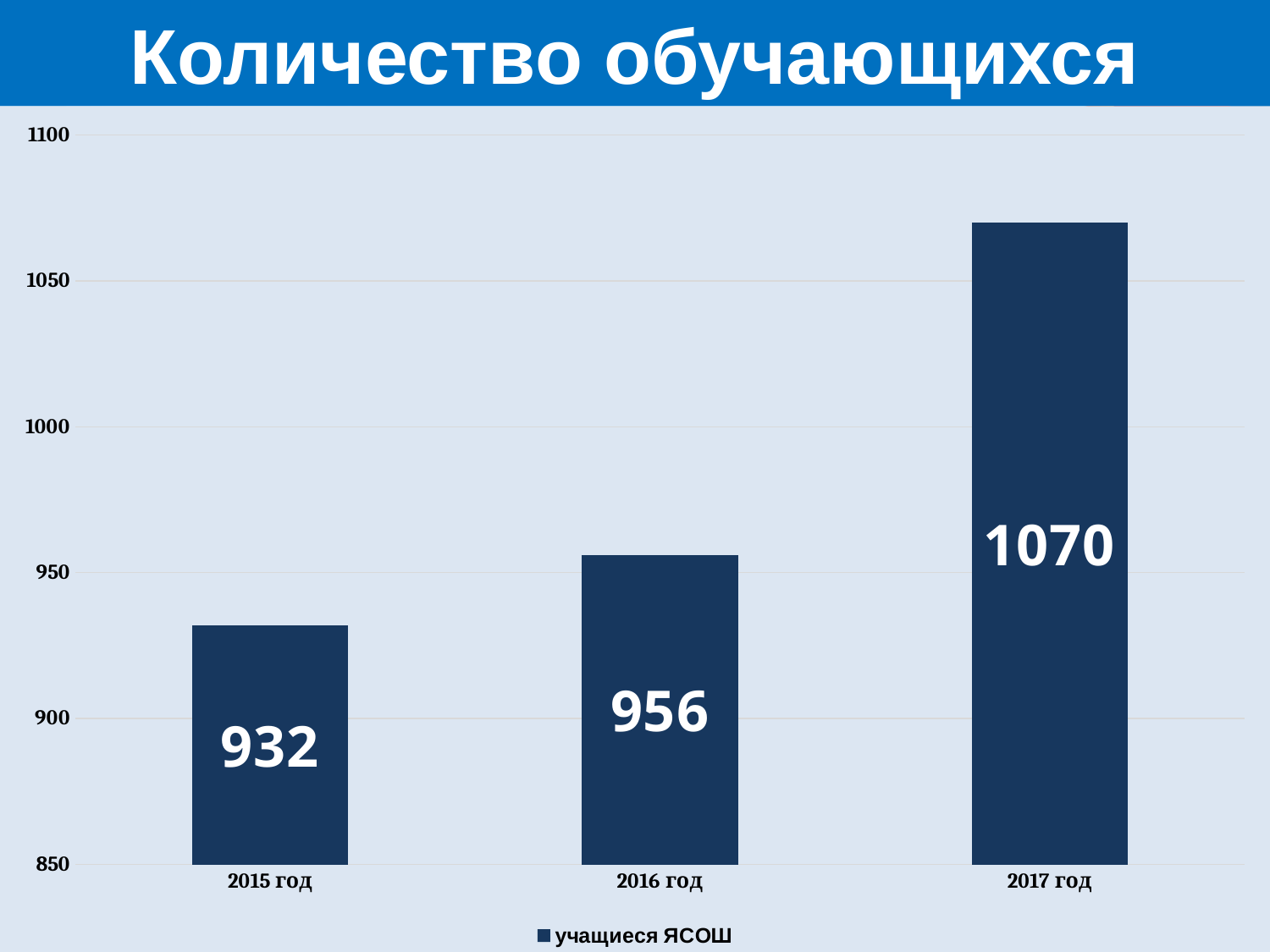
Do the values rise or fall from 2015 год to 2017 год? rise What is the value for 2015 год? 932 What kind of chart is shown on the slide? bar chart What is the difference between the values for 2016 год and 2015 год? 24 Which year has the highest value? 2017 год What is the difference between the values for 2017 год and 2016 год? 114 What is the value for 2017 год? 1070 What is the value for 2016 год? 956 Is the value for 2017 год greater or less than 1050? greater Which year has the lowest value? 2015 год Which is larger, the value for 2016 год or the value for 2015 год? 2016 год How many categories are shown on the x axis? 3